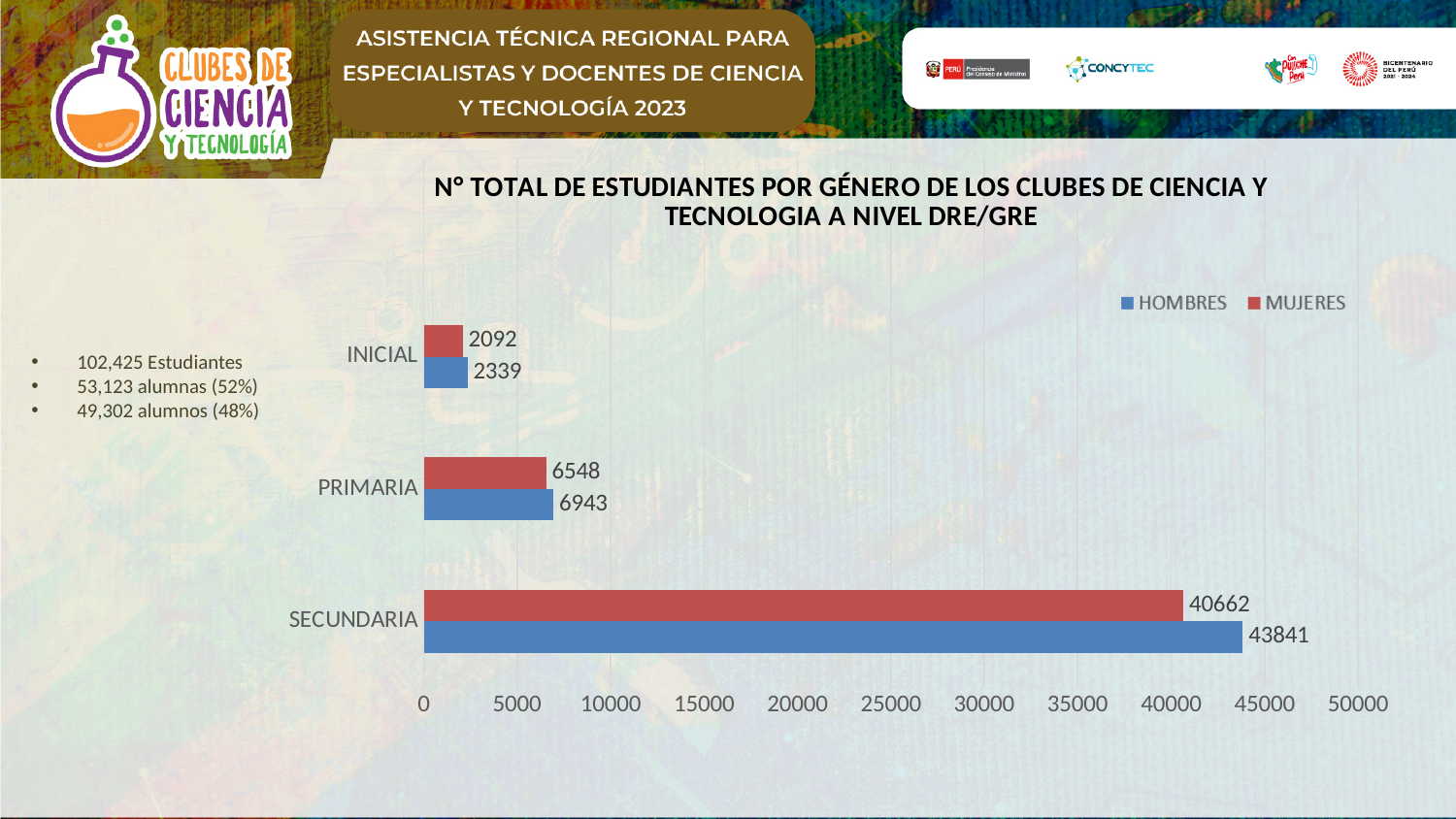
What type of chart is shown on the slide? bar chart What is the MUJERES value for PRIMARIA? 6548 Which category has the lowest MUJERES value? INICIAL What is the MUJERES value for SECUNDARIA? 40662 How many series does the legend list? 2 How many categories (education levels) are shown on the chart? 3 What is the HOMBRES value for SECUNDARIA? 43841 Which category has the highest HOMBRES value? SECUNDARIA Which is larger for PRIMARIA, the HOMBRES value or the MUJERES value? HOMBRES What is the difference between the HOMBRES and MUJERES values for SECUNDARIA? 3179 Which colour represents the MUJERES series in the legend? red What is the HOMBRES value for INICIAL? 2339